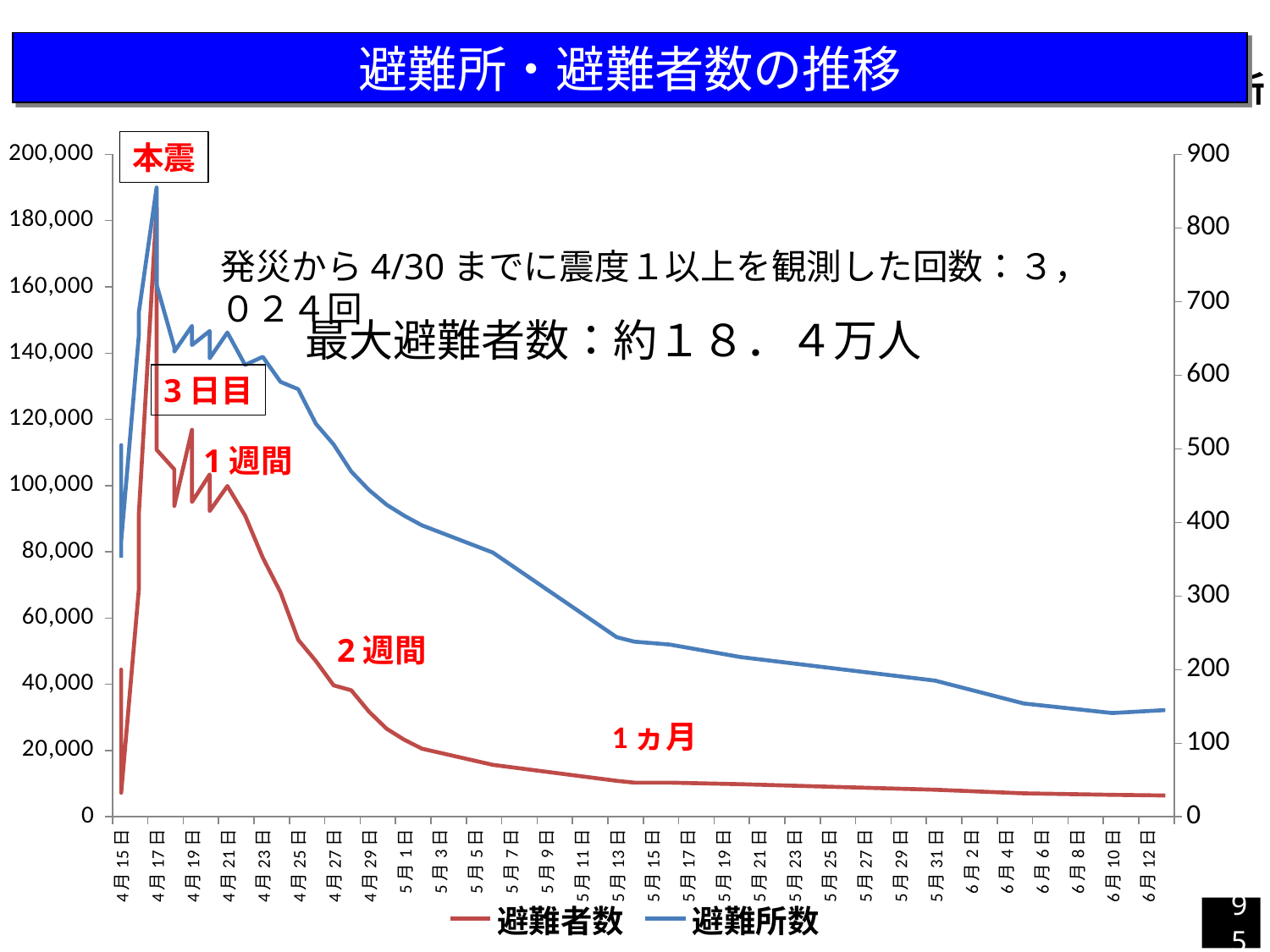
What is the title of the chart? 避難所・避難者数の推移 On which date does 避難所数 reach its highest value? 4月17日 Is the value of 避難者数 on 6月12日 greater or less than 20,000? less Is the peak value of 避難所数 (right axis) greater or less than 800? greater Does 避難者数 rise or fall from 4月21日 to 6月12日? fall What are the two series named in the legend? 避難者数 and 避難所数 Is the value of 避難所数 on 6月12日 greater or less than 200? less On which date does 避難者数 reach its highest value? 4月17日 What kind of chart is shown on the slide? line chart How many series does the legend list? 2